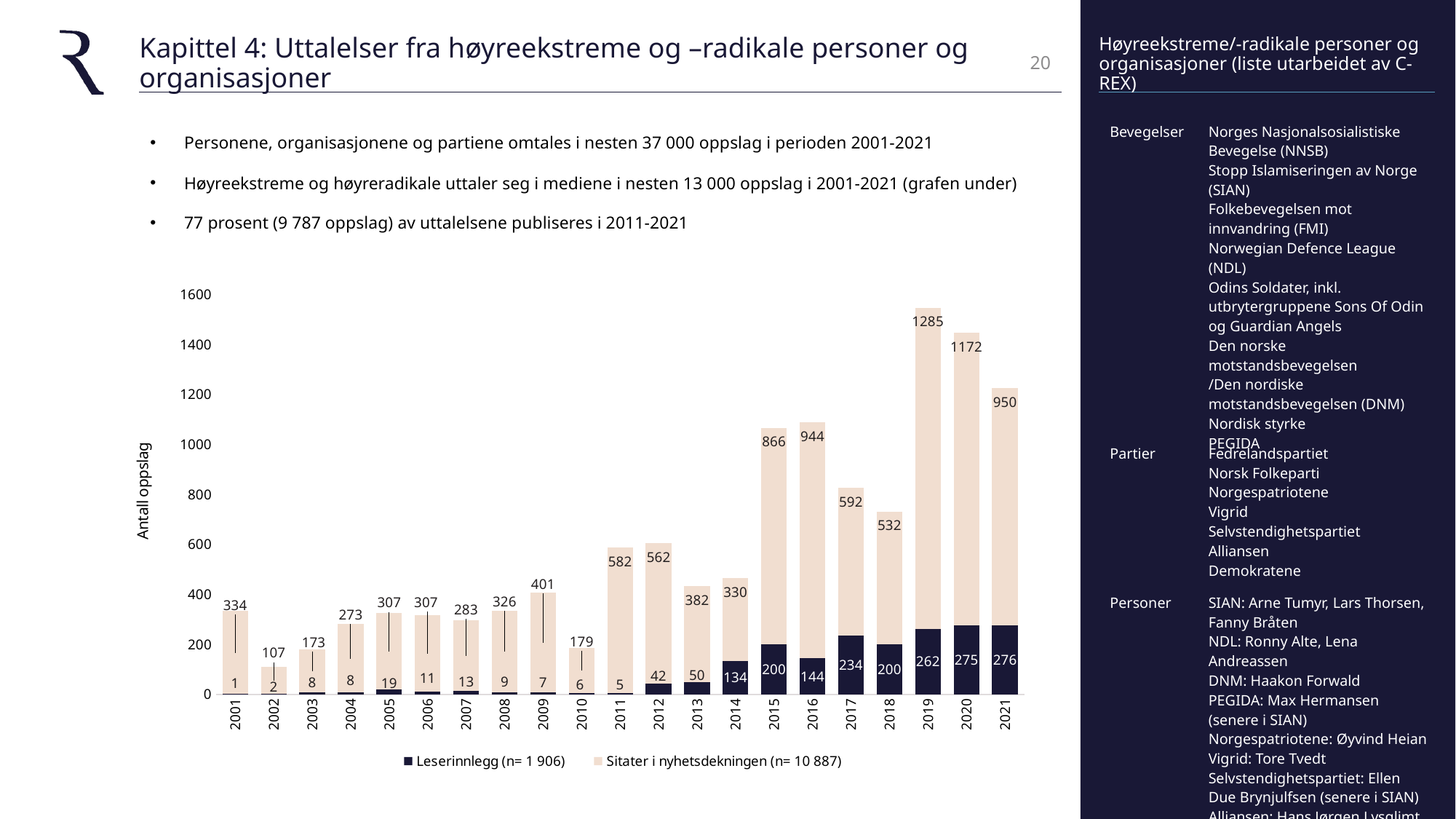
How many series does the chart legend list? 2 What is the value for Leserinnlegg in 2017? 234 Which year has the lowest value for Leserinnlegg? 2001 Which year has the highest value for Sitater i nyhetsdekningen? 2019 How many years are shown on the x axis of the chart? 21 What is the total height of the stacked bar for 2019? 1547 What type of chart is shown on the slide? Stacked bar chart What is the label of the y axis of the chart? Antall oppslag What is the difference between the Sitater i nyhetsdekningen values for 2016 and 2015? 78 Which is larger, the Leserinnlegg value for 2020 or for 2021? 2021 Is the total stacked bar for 2021 greater or less than 1200? greater What is the value for Sitater i nyhetsdekningen in 2019? 1285